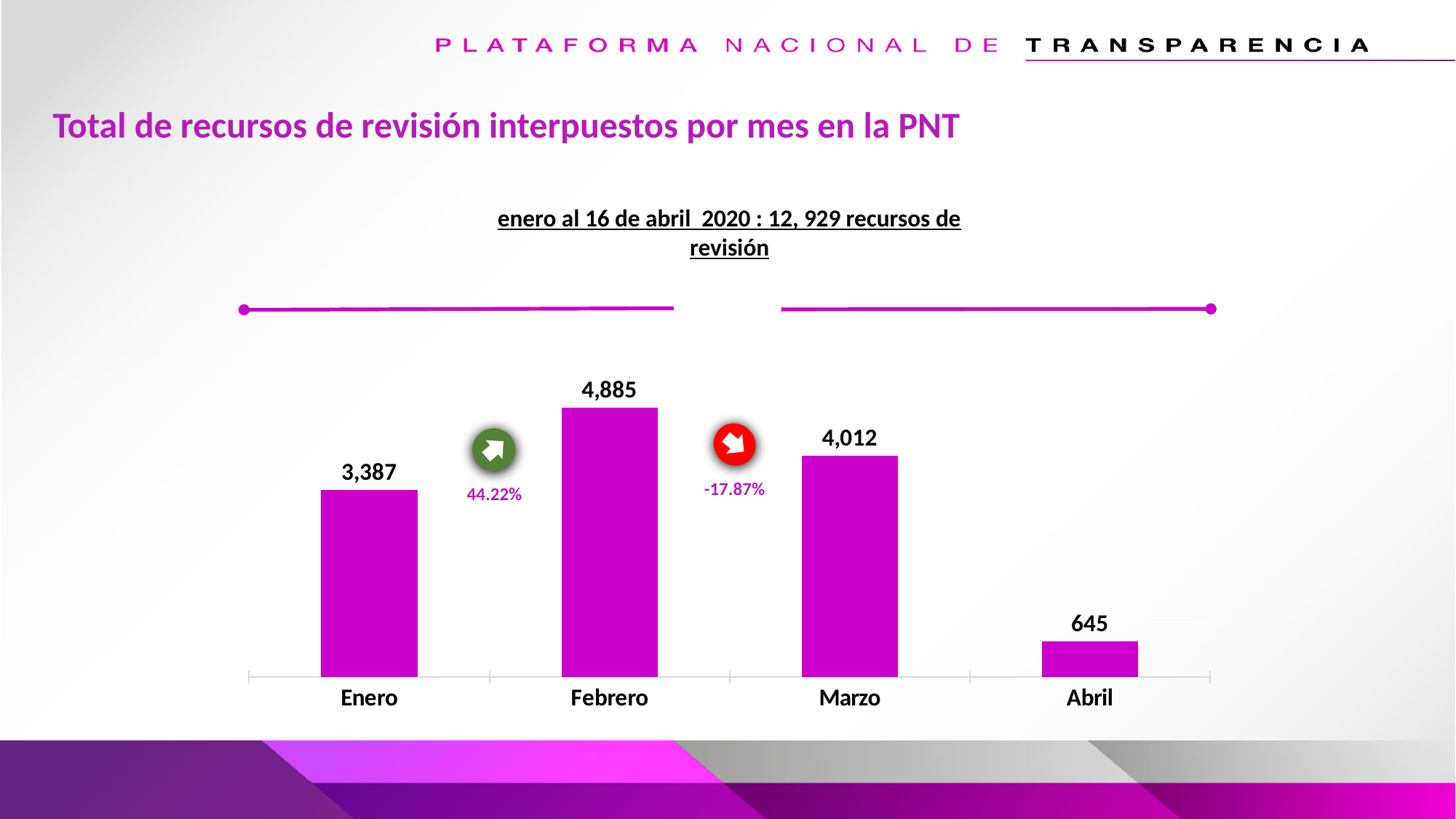
What kind of chart is shown on the slide? Bar chart What is the difference between the values for Febrero and Enero? 1,498 What percentage change is shown between Febrero and Marzo? -17.87% What is the value for Abril? 645 How many months are shown on the chart? 4 What is the value for Febrero? 4,885 What is the value for Marzo? 4,012 What is the difference between the values for Marzo and Abril? 3,367 Which is larger, the value for Enero or the value for Marzo? Marzo Which month has the highest value? Febrero What is the value for Enero? 3,387 Which month has the lowest value? Abril